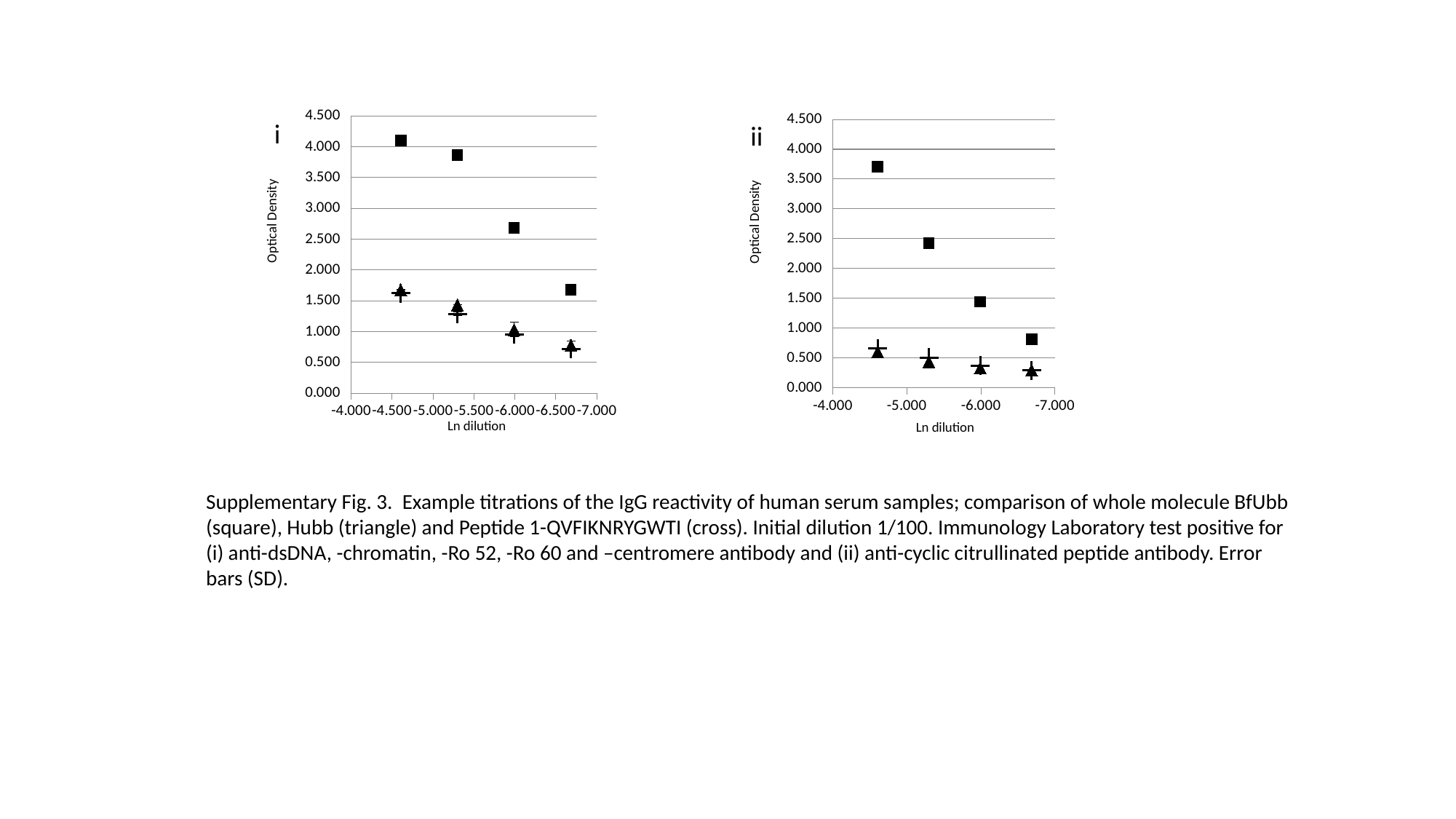
In chart ii, is the value of the rightmost square point greater or less than 1.000? less In chart ii, is the value of the second square point from the left greater or less than 2.000? greater In chart ii, is the value of the leftmost square point greater or less than 3.500? greater What kind of chart is chart i? scatter chart In chart i, at the third x position from the left, which is larger: the square value or the triangle value? square In chart i, do the square values rise or fall as Ln dilution moves from left to right along the x axis? fall What is the x-axis label of chart i? Ln dilution What is the y-axis label of chart ii? Optical Density In chart ii, how many square data points are plotted? 4